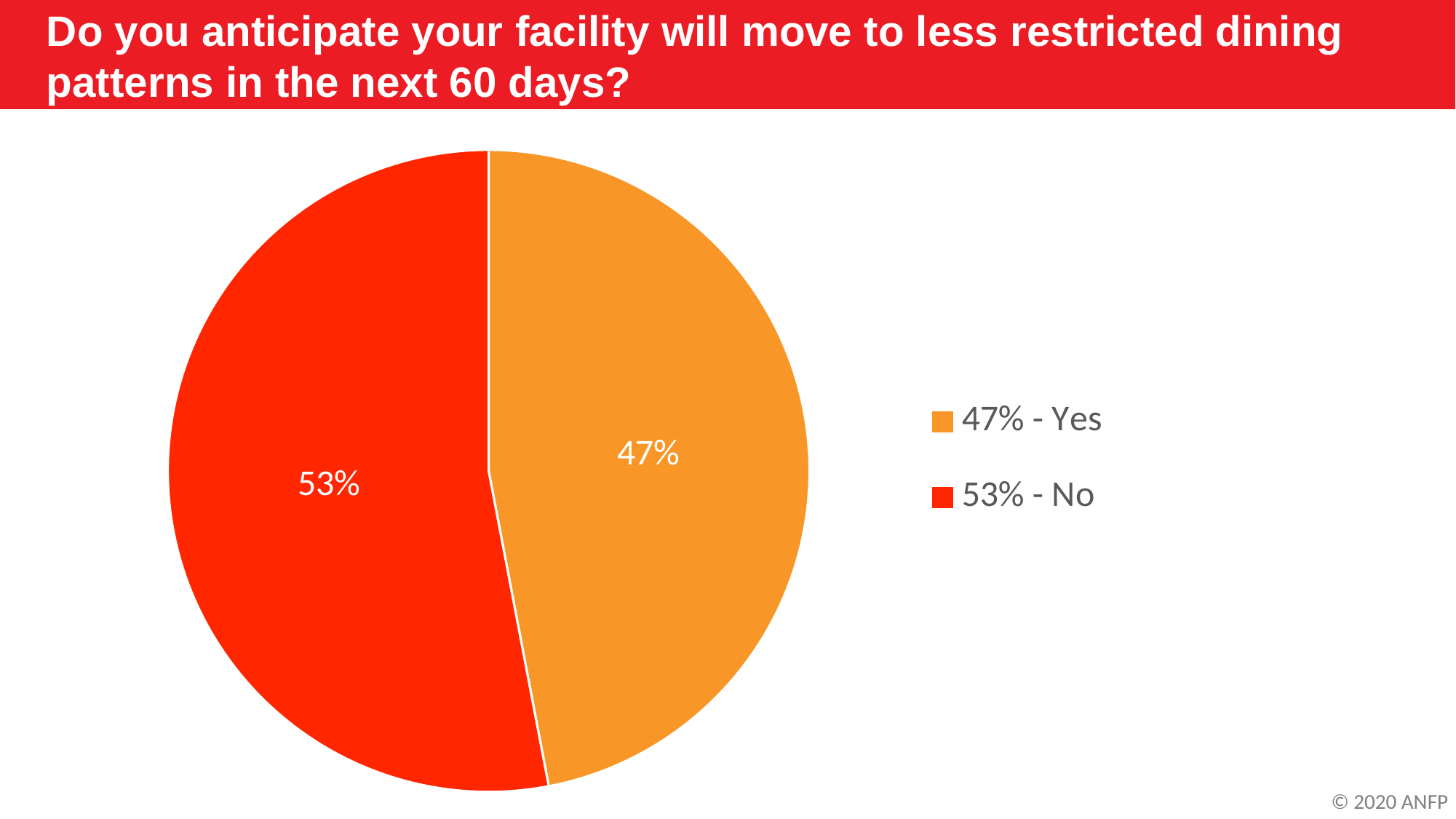
What colour is the slice representing No? red Which response has the larger share of the pie? No What is the combined total of the Yes and No slices? 100% Which response has the smaller share of the pie? Yes What is the difference in percentage points between the No and Yes responses? 6 What percentage of respondents answered No? 53% What question does the chart title ask? Do you anticipate your facility will move to less restricted dining patterns in the next 60 days? What percentage of respondents answered Yes? 47% How many entries does the legend list? 2 How many slices does the pie chart have? 2 What kind of chart is shown on the slide? pie chart Is the share for Yes larger or smaller than the share for No? smaller